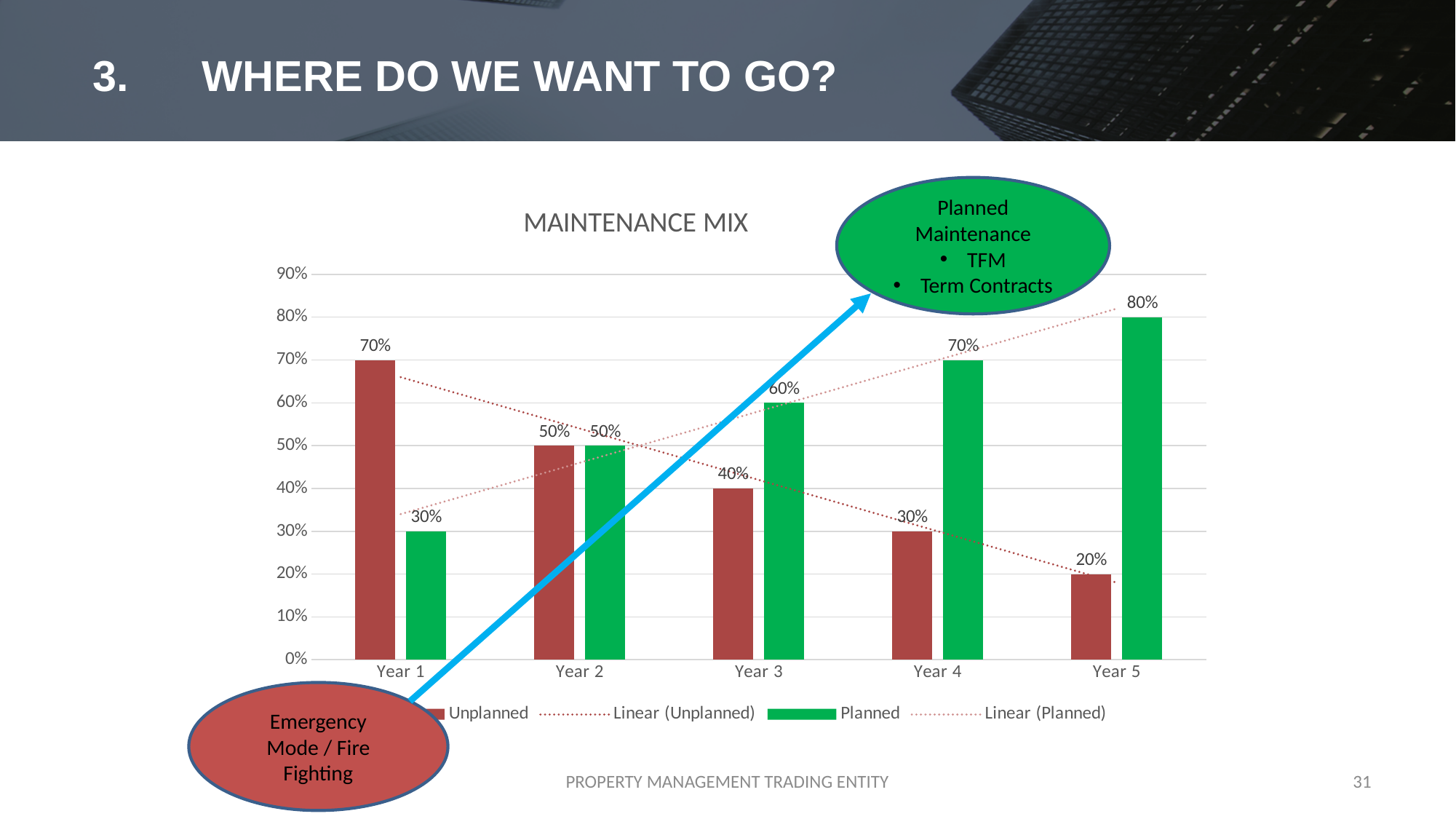
What is the Unplanned value for Year 1? 70% What is the difference between the Planned and Unplanned values in Year 4? 40% How many entries does the legend list? 4 Which is larger in Year 3, the Planned value or the Unplanned value? Planned What is the Planned value for Year 3? 60% What is the Planned value for Year 5? 80% In which year is the Planned value highest? Year 5 In which year is the Unplanned value lowest? Year 5 What is the title of the chart? MAINTENANCE MIX What kind of chart is this? Bar chart Do the Unplanned values rise or fall from Year 1 to Year 5? Fall How many years are shown on the x axis? 5